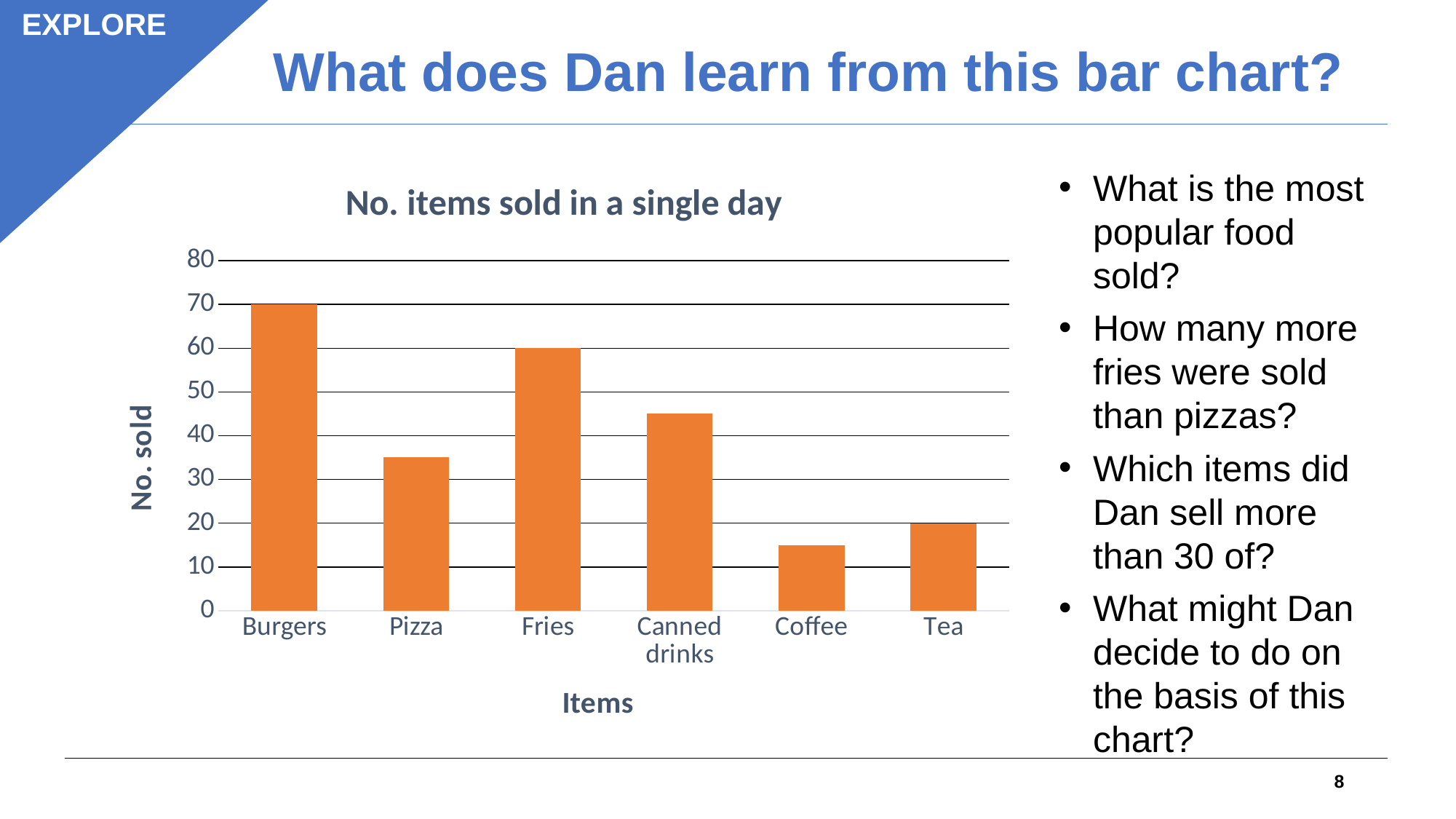
Which item has the highest number sold? Burgers Which sold more, Canned drinks or Pizza? Canned drinks How many teas were sold? 20 How many more burgers were sold than fries? 10 What is the title of the chart? No. items sold in a single day How many fries were sold? 60 Is the value for Coffee greater or less than 20? less Is the value for Pizza greater or less than 30? greater How many items (categories) are shown on the x axis of the chart? 6 Which item has the lowest number sold? Coffee What type of chart is shown on the slide? bar chart How many burgers were sold? 70